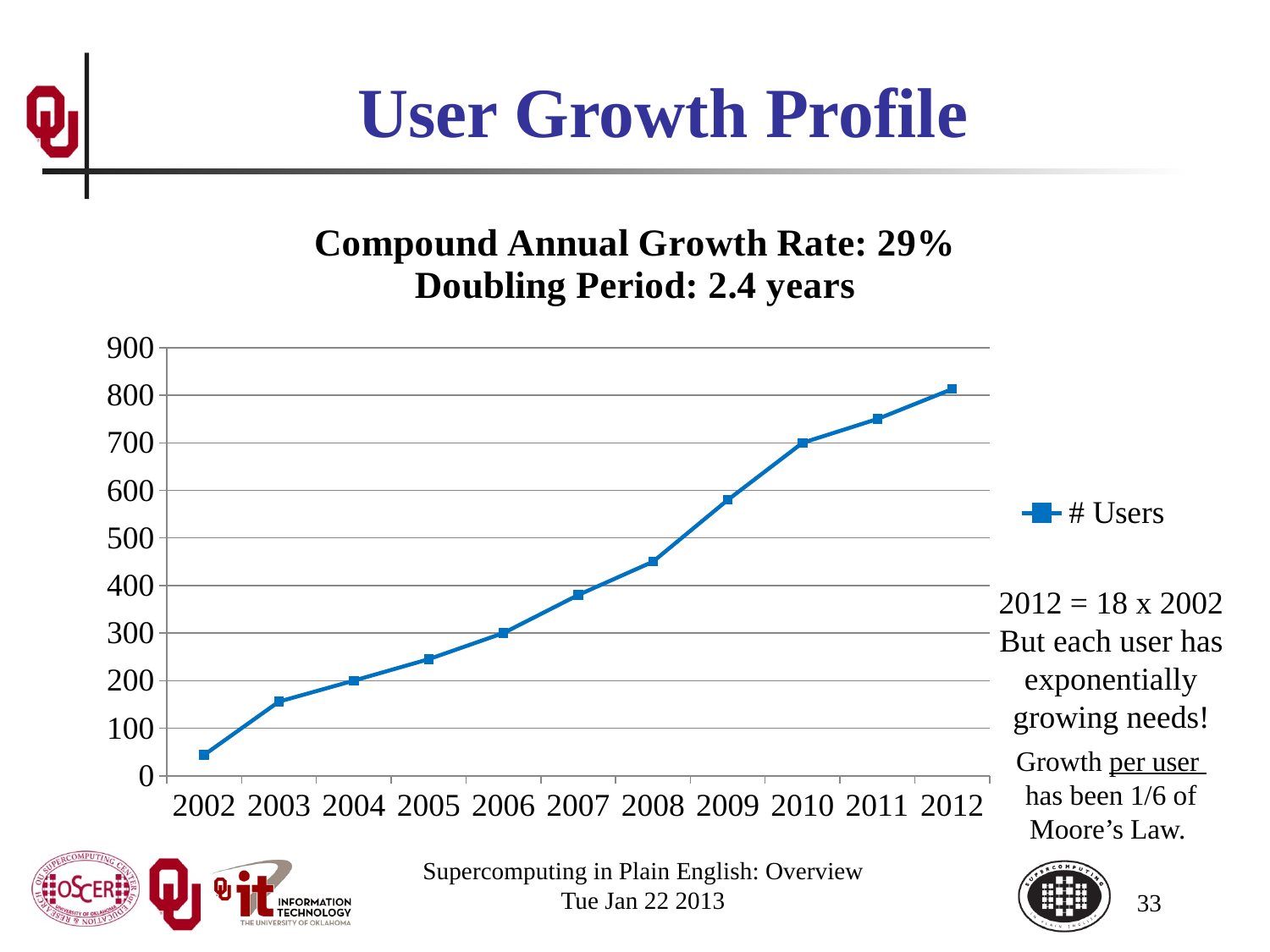
Which year has the lowest number of users? 2002 How many years are plotted on the x axis? 11 What is the name of the series shown in the legend? # Users Is the value for 2009 greater or less than 500? greater Do the values rise or fall from 2002 to 2012? rise How many series does the legend list? 1 What kind of chart is shown on the slide? line chart Is the value for 2002 greater or less than 100? less Which year has the highest number of users? 2012 Which year has more users, 2005 or 2010? 2010 Is the value for 2008 greater or less than 500? less